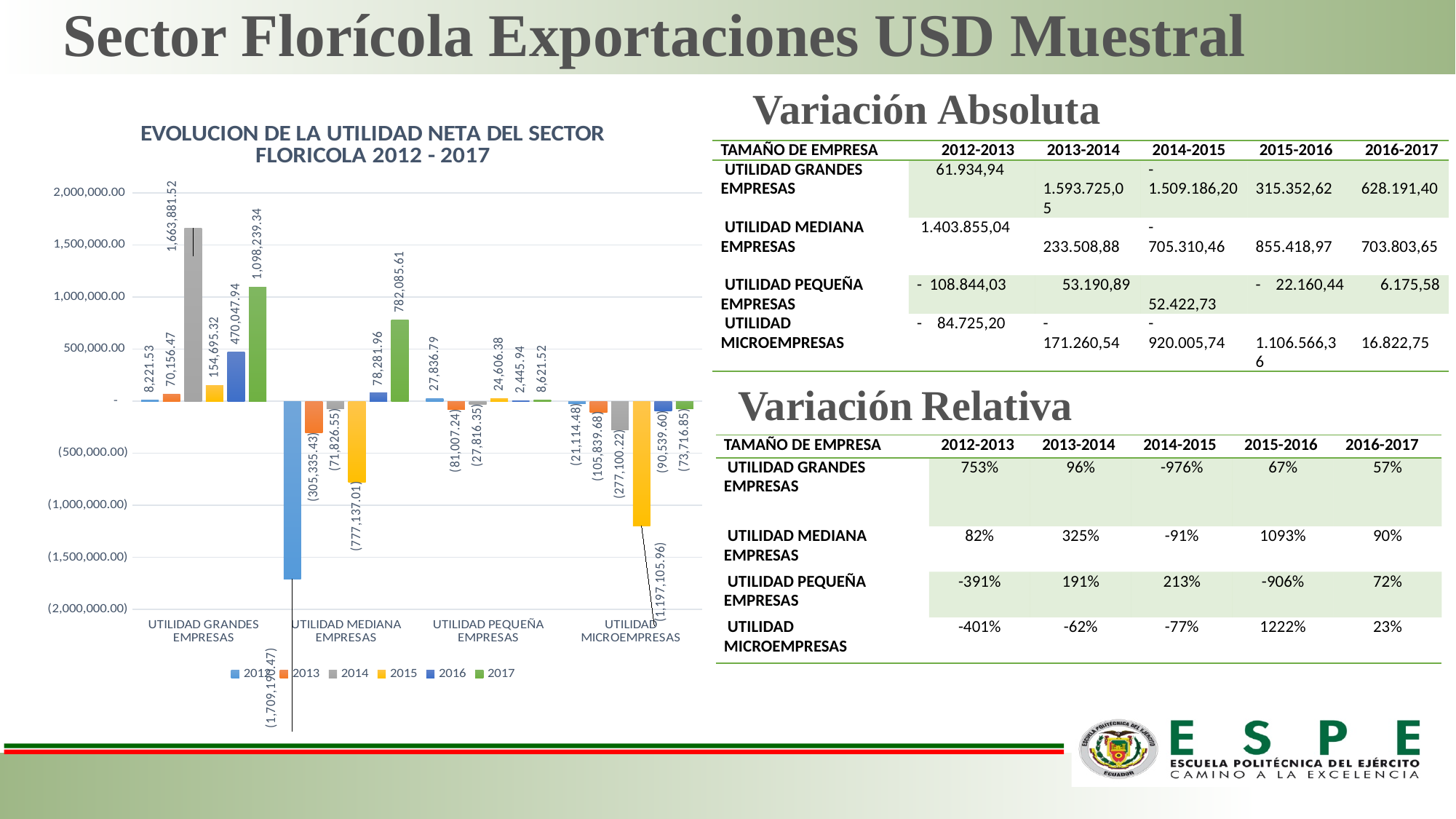
What is the value for UTILIDAD MICROEMPRESAS in 2015? (1,197,105.96) What is the value for UTILIDAD GRANDES EMPRESAS in 2014? 1,663,881.52 How many company-size categories are shown on the x axis of the chart? 4 How many series does the legend of the chart list? 6 Which year has the lowest value for UTILIDAD MICROEMPRESAS? 2015 What type of chart is shown on the slide? Bar chart Which year has the highest value for UTILIDAD GRANDES EMPRESAS? 2014 What is the value for UTILIDAD PEQUEÑA EMPRESAS in 2016? 2,445.94 Is the 2012 value for UTILIDAD MEDIANA EMPRESAS greater or less than (1,500,000.00)? less What is the difference between the 2017 and 2016 values for UTILIDAD GRANDES EMPRESAS? 628,191.40 Which is larger for UTILIDAD GRANDES EMPRESAS: the 2016 value or the 2017 value? 2017 What is the value for UTILIDAD MEDIANA EMPRESAS in 2017? 782,085.61